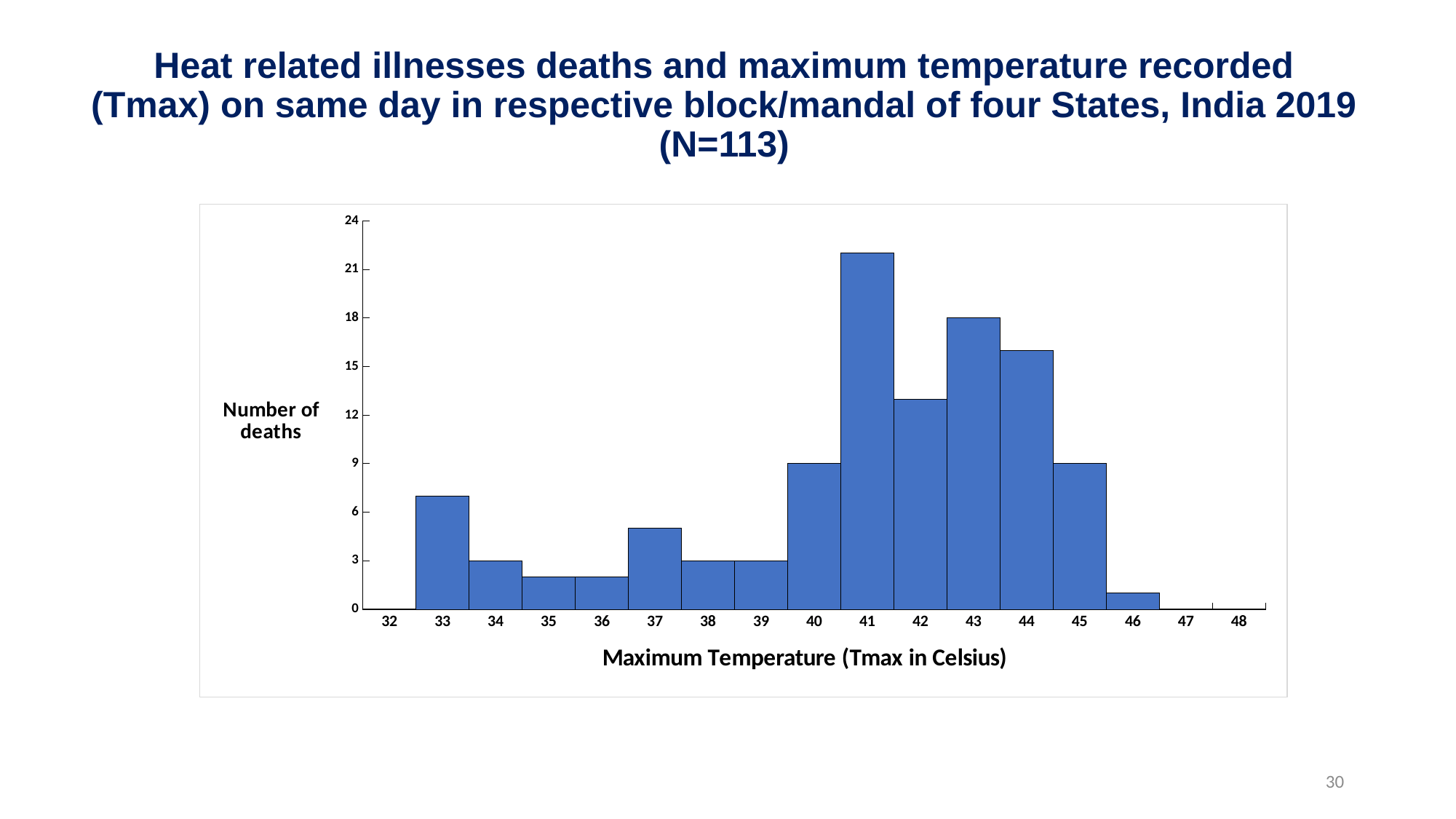
What is the title of the y axis? Number of deaths Is the number of deaths at a maximum temperature of 33 greater or less than 6? greater What is the number of deaths at a maximum temperature of 43? 18 Do the number of deaths rise or fall from a maximum temperature of 43 to 46? fall What is the number of deaths at a maximum temperature of 34? 3 Which has more deaths, a maximum temperature of 41 or 43? 41 Which maximum temperature has the highest number of deaths? 41 What is the difference in the number of deaths between a maximum temperature of 43 and 45? 9 Is the number of deaths at a maximum temperature of 41 greater or less than 21? greater What is the number of deaths at a maximum temperature of 40? 9 What type of chart is shown on the slide? bar chart Is the number of deaths at a maximum temperature of 46 greater or less than 3? less